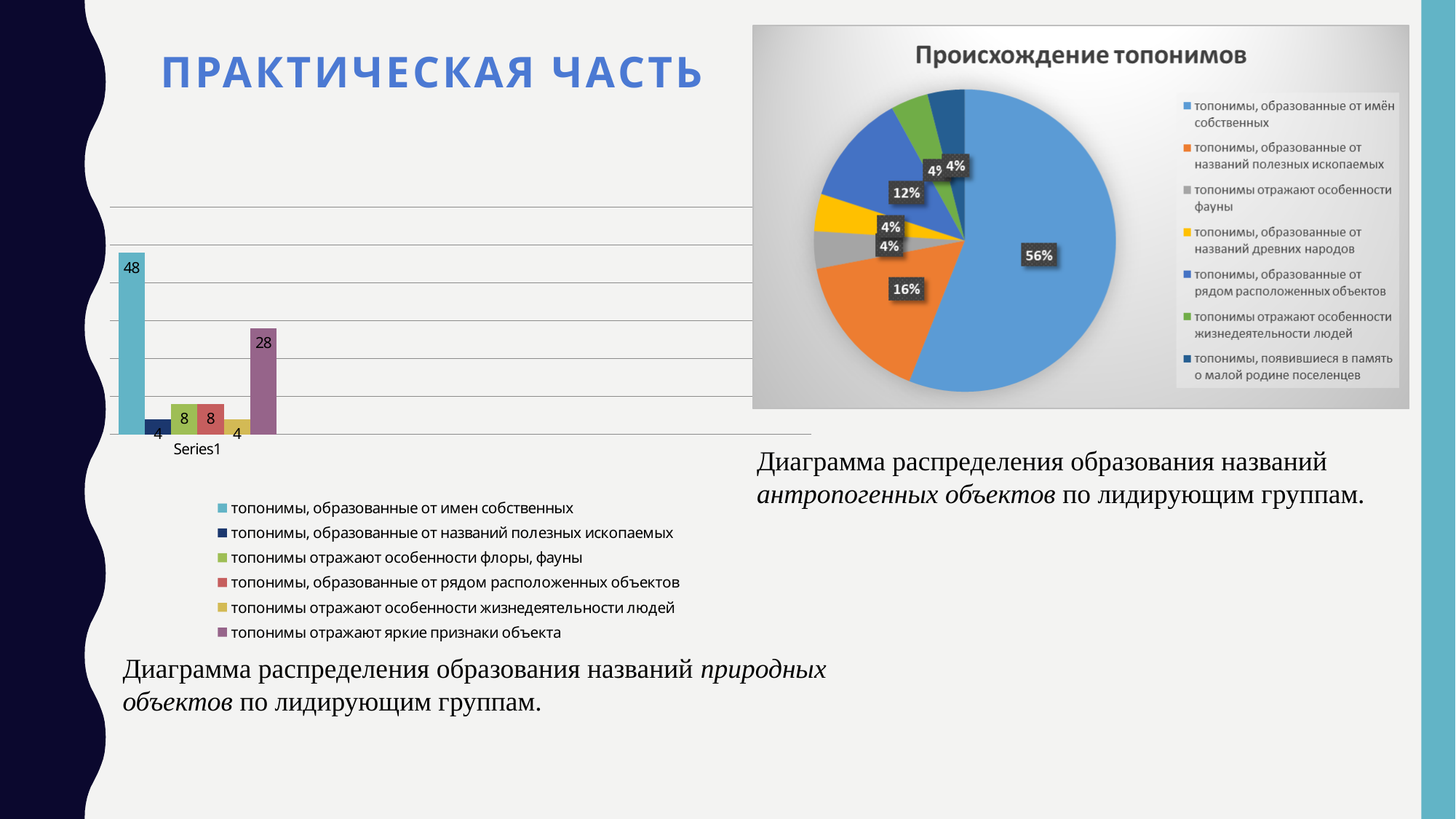
In the bar chart on the left, which category has the highest value? топонимы, образованные от имен собственных In the bar chart on the left, what is the difference between the values for топонимы, образованные от имен собственных and топонимы отражают яркие признаки объекта? 20 In the bar chart on the left, what is the value for топонимы отражают яркие признаки объекта? 28 What is the title of the pie chart on the right of the slide? Происхождение топонимов In the pie chart 'Происхождение топонимов', what share do топонимы, образованные от рядом расположенных объектов have? 12% In the bar chart on the left, how many series does the legend list? 6 In the bar chart on the left, what is the value for топонимы, образованные от имен собственных? 48 What kind of chart is the chart on the left of the slide? bar chart In the bar chart on the left, which is larger: the value for топонимы отражают особенности флоры, фауны or the value for топонимы, образованные от названий полезных ископаемых? топонимы отражают особенности флоры, фауны In the pie chart 'Происхождение топонимов', what share do топонимы, образованные от названий полезных ископаемых have? 16% In the pie chart 'Происхождение топонимов', what share do топонимы, образованные от имён собственных have? 56% In the pie chart 'Происхождение топонимов', how many categories does the legend list? 7